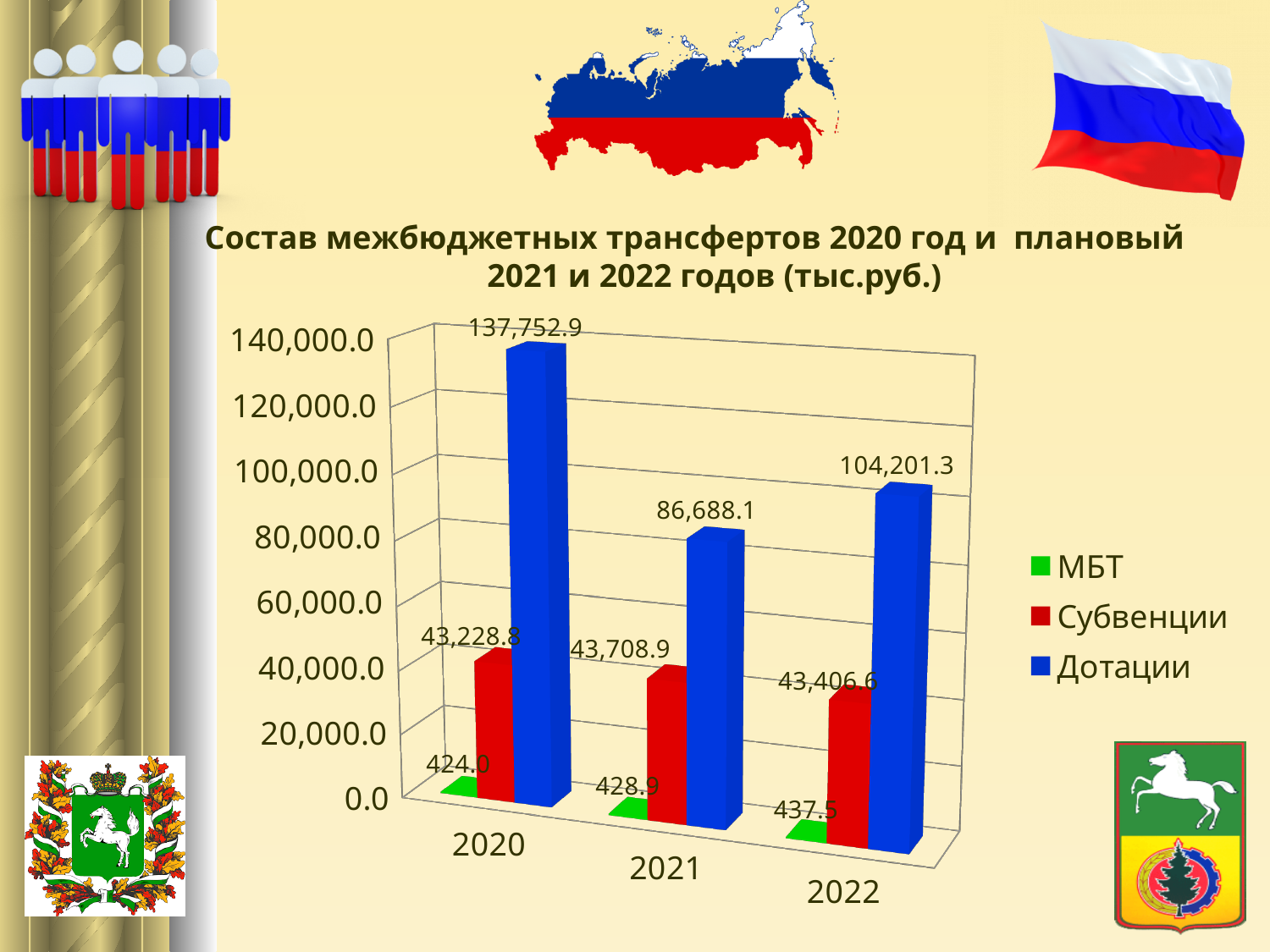
What is the difference between the Дотации values for 2022 and 2021? 17,513.2 What is the value of МБТ for 2022? 437.5 Do the МБТ values rise or fall from 2020 to 2022? rise What is the difference between the Дотации values for 2020 and 2021? 51,064.8 What is the value of Дотации for 2022? 104,201.3 In which year is the value of Дотации lowest? 2021 In which year is the value of Дотации highest? 2020 What is the value of Дотации for 2020? 137,752.9 Which is larger: Дотации for 2021 or Дотации for 2022? Дотации for 2022 How many years are shown on the x axis? 3 What is the value of Субвенции for 2021? 43,708.9 How many series does the legend list? 3